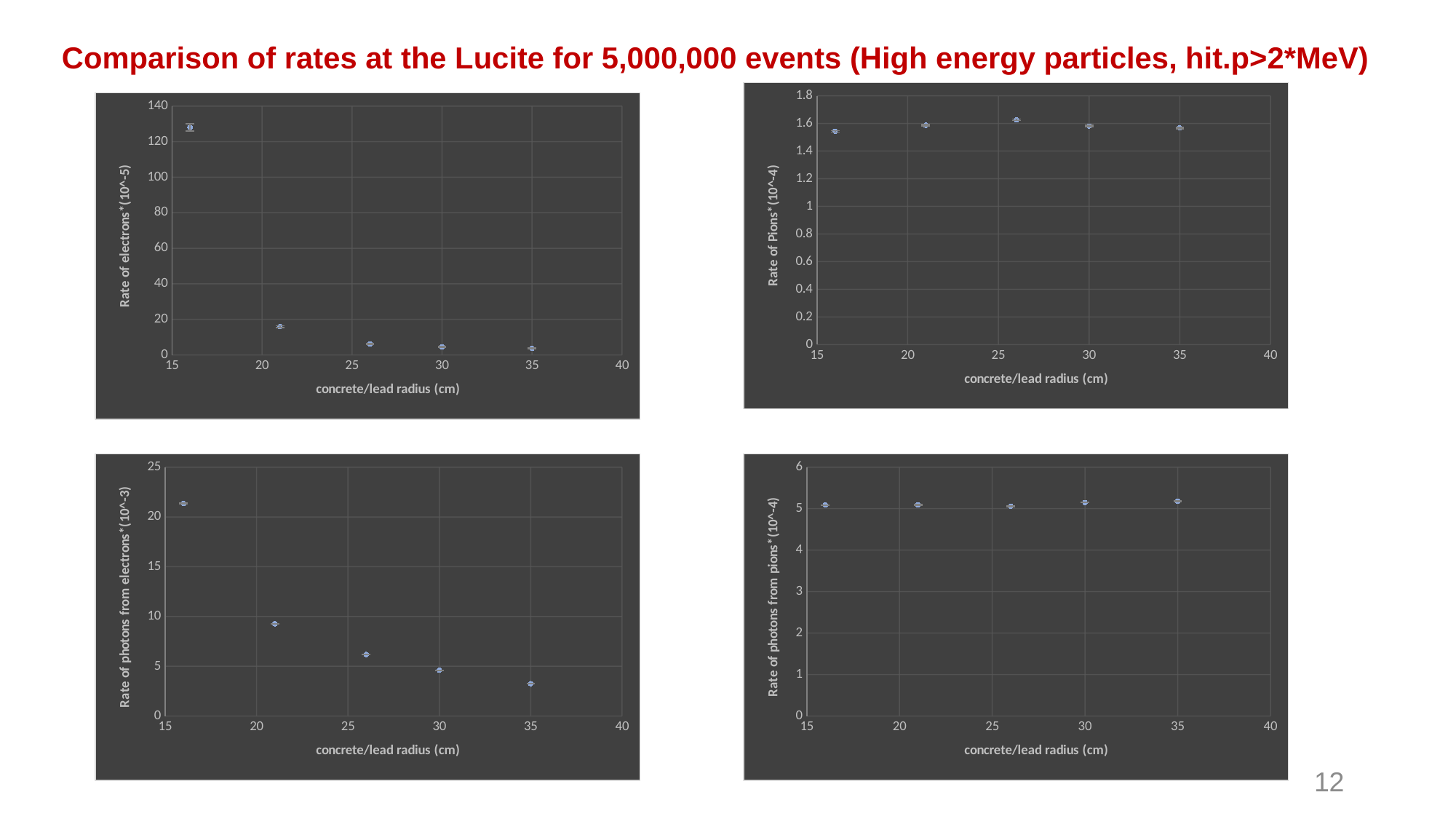
In the top-right chart (Rate of Pions*(10^-4)), is the value at a radius of 35 cm greater or less than 1.2? greater In the top-left chart (Rate of electrons*(10^-5)), is the value at the smallest radius (about 16 cm) greater or less than 120? greater What kind of chart is the top-left chart (Rate of electrons*(10^-5))? scatter chart In the top-right chart (Rate of Pions*(10^-4)), is the value at a radius of 30 cm greater or less than 1.4? greater In the bottom-left chart (Rate of photons from electrons*(10^-3)), do the values rise or fall as the concrete/lead radius increases? fall How many data points are plotted in the top-left chart (Rate of electrons*(10^-5))? 5 In the top-left chart (Rate of electrons*(10^-5)), do the values rise or fall as the concrete/lead radius increases? fall What is the x-axis label shared by all four charts on the slide? concrete/lead radius (cm) In the bottom-left chart (Rate of photons from electrons*(10^-3)), which has the larger value: the point at about 21 cm or the point at 35 cm? the point at about 21 cm